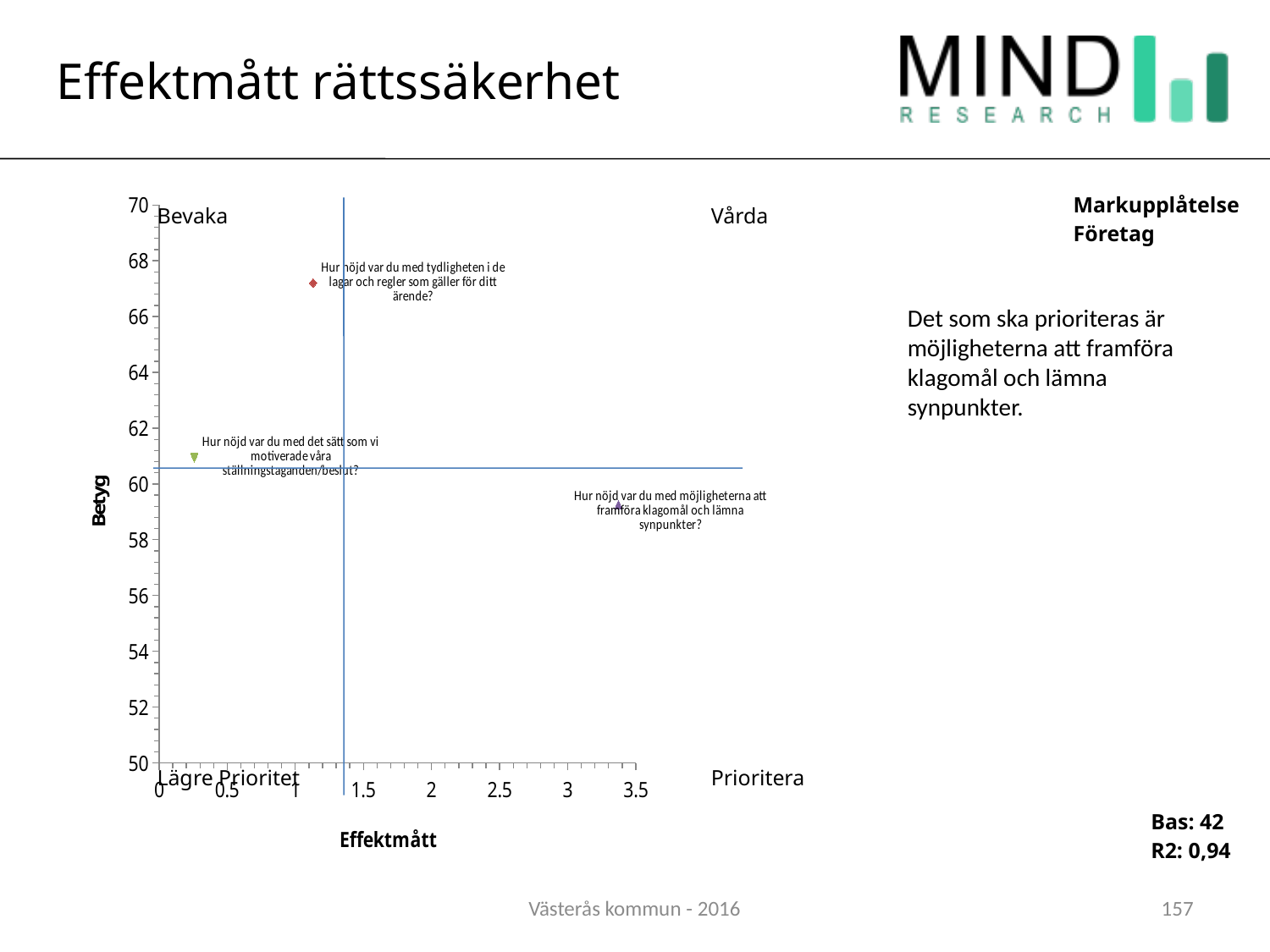
Which data point has the lowest Betyg value? Hur nöjd var du med möjligheterna att framföra klagomål och lämna synpunkter? Which data point has the highest Effektmått value? Hur nöjd var du med möjligheterna att framföra klagomål och lämna synpunkter? Is the Betyg value for 'Hur nöjd var du med tydligheten i de lagar och regler som gäller för ditt ärende?' greater or less than 66? greater Is the Effektmått value for 'Hur nöjd var du med det sätt som vi motiverade våra ställningstaganden/beslut?' greater or less than 0.5? less Which data point has the highest Betyg value? Hur nöjd var du med tydligheten i de lagar och regler som gäller för ditt ärende? What kind of chart is shown on the slide? scatter chart Which data point has the lowest Effektmått value? Hur nöjd var du med det sätt som vi motiverade våra ställningstaganden/beslut? What is the title of the vertical axis of the chart? Betyg Which has a higher Betyg value: 'Hur nöjd var du med det sätt som vi motiverade våra ställningstaganden/beslut?' or 'Hur nöjd var du med möjligheterna att framföra klagomål och lämna synpunkter?' Hur nöjd var du med det sätt som vi motiverade våra ställningstaganden/beslut? What is the title of the horizontal axis of the chart? Effektmått How many data points are plotted in the chart? 3 Is the Effektmått value for 'Hur nöjd var du med möjligheterna att framföra klagomål och lämna synpunkter?' greater or less than 3? greater